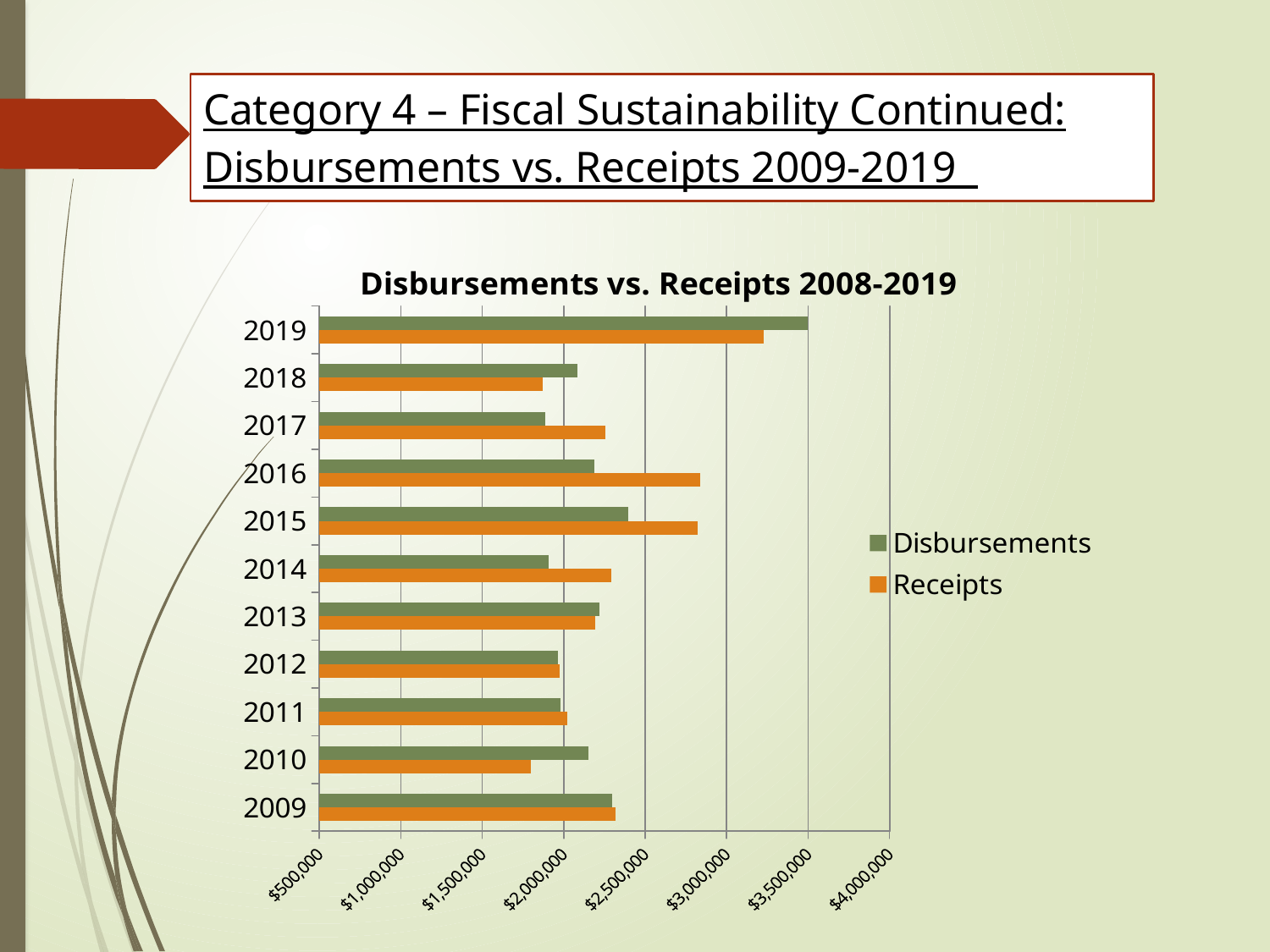
Is the Receipts value for 2010 greater or less than $2,000,000? less In 2019, which is larger, Disbursements or Receipts? Disbursements What is the title of the chart? Disbursements vs. Receipts 2008-2019 In 2016, which is larger, Disbursements or Receipts? Receipts How many series does the legend list? 2 In 2010, which is larger, Disbursements or Receipts? Disbursements How many years are shown on the chart? 11 What kind of chart is shown on the slide? Bar chart Is the Receipts value for 2016 greater or less than $2,500,000? greater Which year has the highest Receipts value? 2019 Which year has the highest Disbursements value? 2019 Is the Disbursements value for 2019 greater or less than $3,000,000? greater